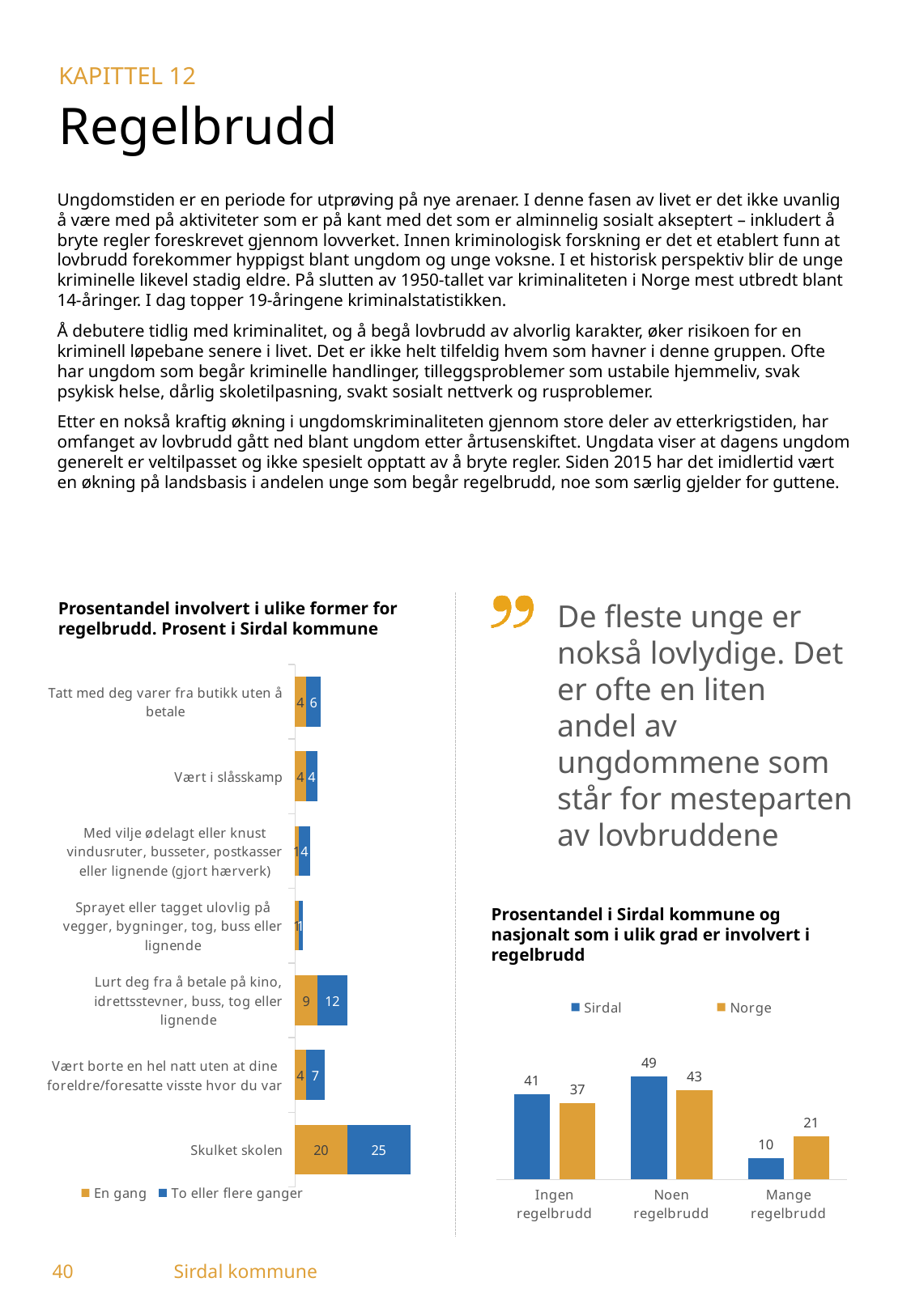
In the chart 'Prosentandel i Sirdal kommune og nasjonalt som i ulik grad er involvert i regelbrudd', what is the value for Sirdal in the category 'Noen regelbrudd'? 49 In the chart 'Prosentandel i Sirdal kommune og nasjonalt som i ulik grad er involvert i regelbrudd', what is the difference between Sirdal and Norge for 'Ingen regelbrudd'? 4 In the chart 'Prosentandel i Sirdal kommune og nasjonalt som i ulik grad er involvert i regelbrudd', what is the value for Norge in the category 'Mange regelbrudd'? 21 In the chart 'Prosentandel involvert i ulike former for regelbrudd. Prosent i Sirdal kommune', what is the value of 'To eller flere ganger' for 'Skulket skolen'? 25 How many series does the legend list in the chart 'Prosentandel i Sirdal kommune og nasjonalt som i ulik grad er involvert i regelbrudd'? 2 In the chart 'Prosentandel involvert i ulike former for regelbrudd. Prosent i Sirdal kommune', which category has the highest total? Skulket skolen In the chart 'Prosentandel involvert i ulike former for regelbrudd. Prosent i Sirdal kommune', what is the total of the stacked bar for 'Lurt deg fra å betale på kino, idrettsstevner, buss, tog eller lignende'? 21 In the chart 'Prosentandel involvert i ulike former for regelbrudd. Prosent i Sirdal kommune', what is the value of 'En gang' for 'Vært borte en hel natt uten at dine foreldre/foresatte visste hvor du var'? 4 In the chart 'Prosentandel involvert i ulike former for regelbrudd. Prosent i Sirdal kommune', how many categories are shown? 7 In the chart 'Prosentandel i Sirdal kommune og nasjonalt som i ulik grad er involvert i regelbrudd', which is larger for 'Mange regelbrudd', Sirdal or Norge? Norge In the chart 'Prosentandel i Sirdal kommune og nasjonalt som i ulik grad er involvert i regelbrudd', which category has the lowest value for Sirdal? Mange regelbrudd What kind of chart is 'Prosentandel involvert i ulike former for regelbrudd. Prosent i Sirdal kommune'? Stacked bar chart